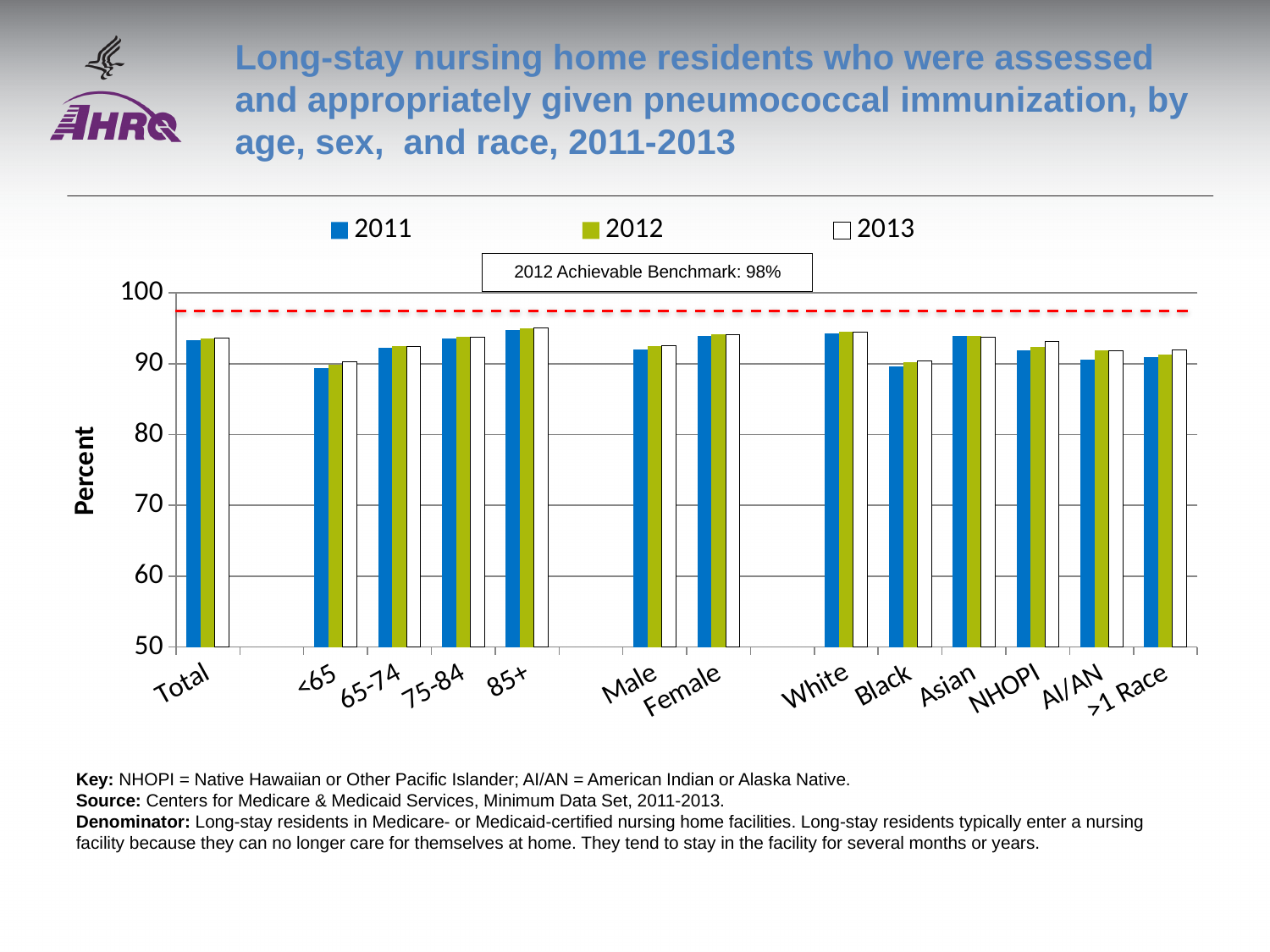
How many series does the legend list? 3 Among the age groups (<65, 65-74, 75-84, 85+), which has the highest 2013 value? 85+ How many categories are shown along the x axis? 13 What is the 2012 achievable benchmark shown on the chart? 98% Which years are listed in the legend? 2011, 2012, 2013 Is the 2013 value for 85+ greater or less than 90? greater In 2011, which is larger, the value for White or the value for Black? White What kind of chart is shown on the slide? Bar chart Among the age groups (<65, 65-74, 75-84, 85+), which has the lowest 2011 value? <65 Is the 2011 value for <65 greater or less than 90? less Is the 2012 value for Total greater or less than 90? greater